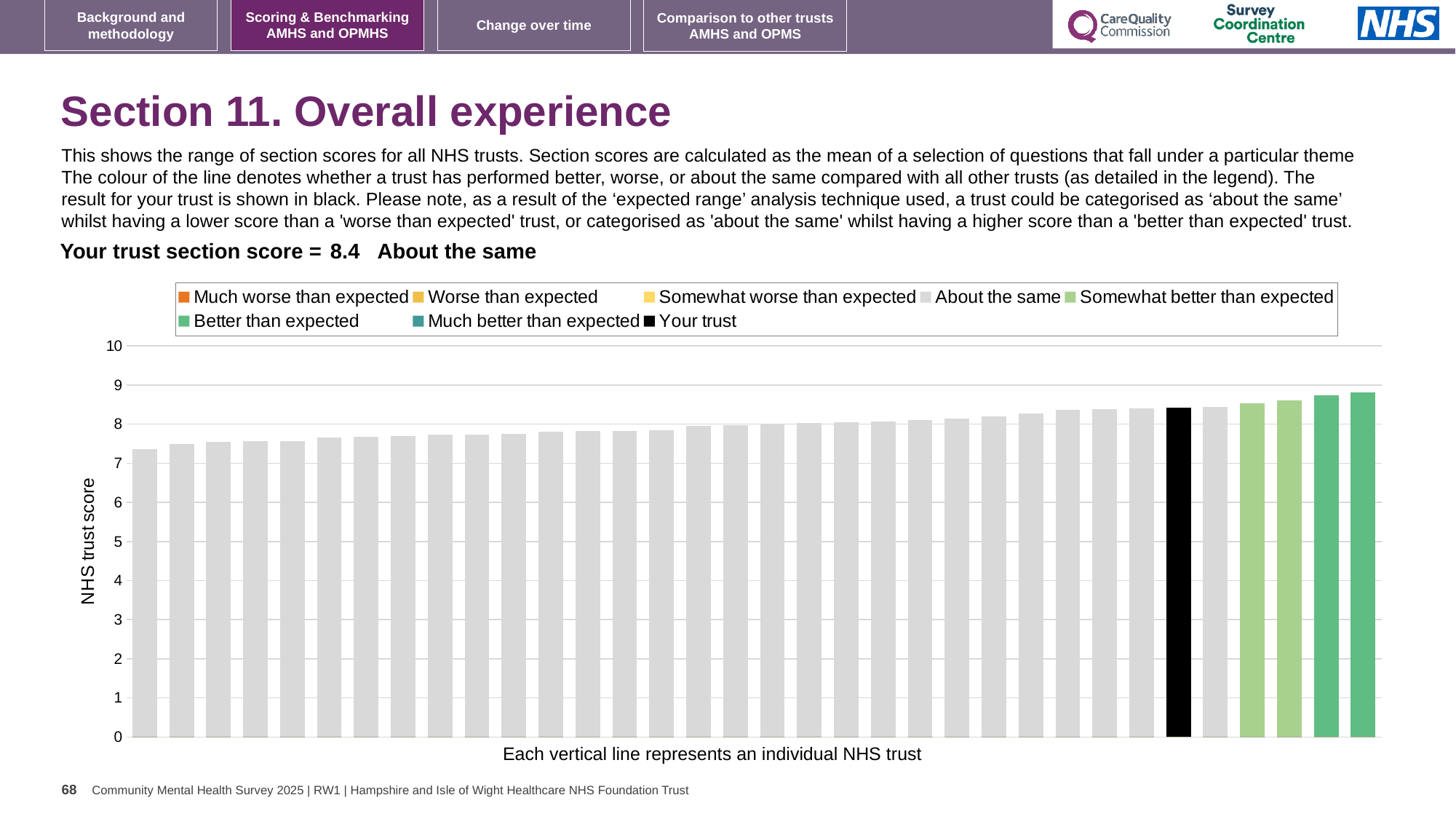
How many bars are coloured green (somewhat better or better than expected) in the chart? 4 How many entries does the chart legend list? 8 Is the value of the black bar (your trust) greater or less than 8? greater What is the label on the vertical axis of the chart? NHS trust score What kind of chart is shown on the slide? bar chart Which category does the slide assign to your trust's section score? About the same Which bar is the highest in the chart: the leftmost or the rightmost? rightmost What is the section score for your trust shown on the slide? 8.4 Do the bar values rise or fall from left to right across the chart? rise Is the value of the highest (rightmost) bar greater or less than 9? less Is the value of the lowest (leftmost) bar greater or less than 7? greater Which bar is the lowest in the chart: the leftmost or the rightmost? leftmost